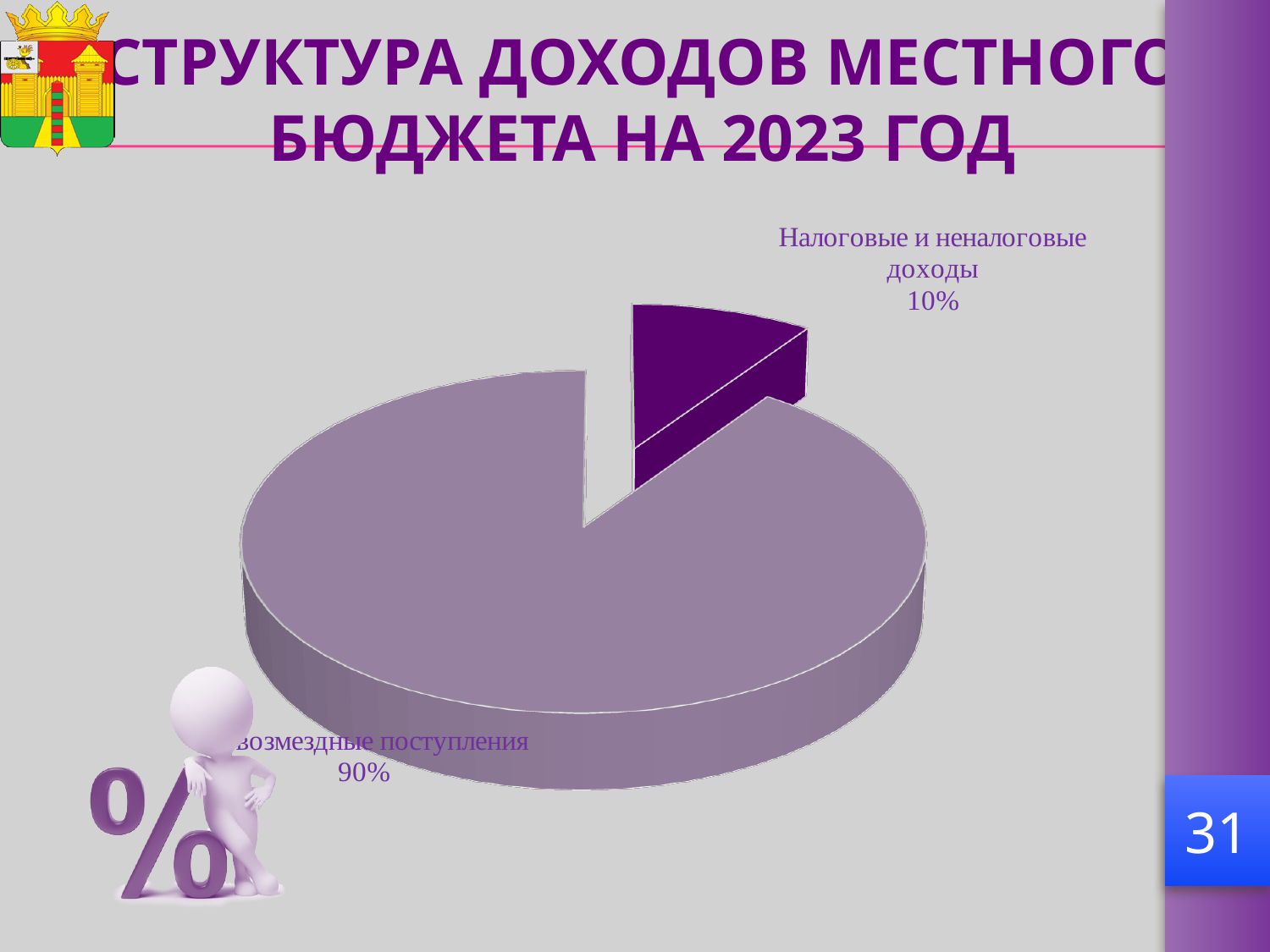
Which slice of the pie is pulled out (exploded) from the rest of the pie? Налоговые и неналоговые доходы What share of the pie is labelled "Налоговые и неналоговые доходы"? 10% What is the title of the slide containing the pie chart? СТРУКТУРА ДОХОДОВ МЕСТНОГО БЮДЖЕТА НА 2023 ГОД What is the total of the two percentages shown on the pie chart? 100% Which slice of the pie is the largest? Безвозмездные поступления Which is larger: the share for "Налоговые и неналоговые доходы" or the share for "Безвозмездные поступления"? Безвозмездные поступления What kind of chart is shown on the slide? Pie chart How many slices does the pie chart have? 2 What share of the pie does the slice labelled "Безвозмездные поступления" represent? 90% What is the difference in percentage points between the "Безвозмездные поступления" slice and the "Налоговые и неналоговые доходы" slice? 80 percentage points Which slice of the pie is the smallest? Налоговые и неналоговые доходы